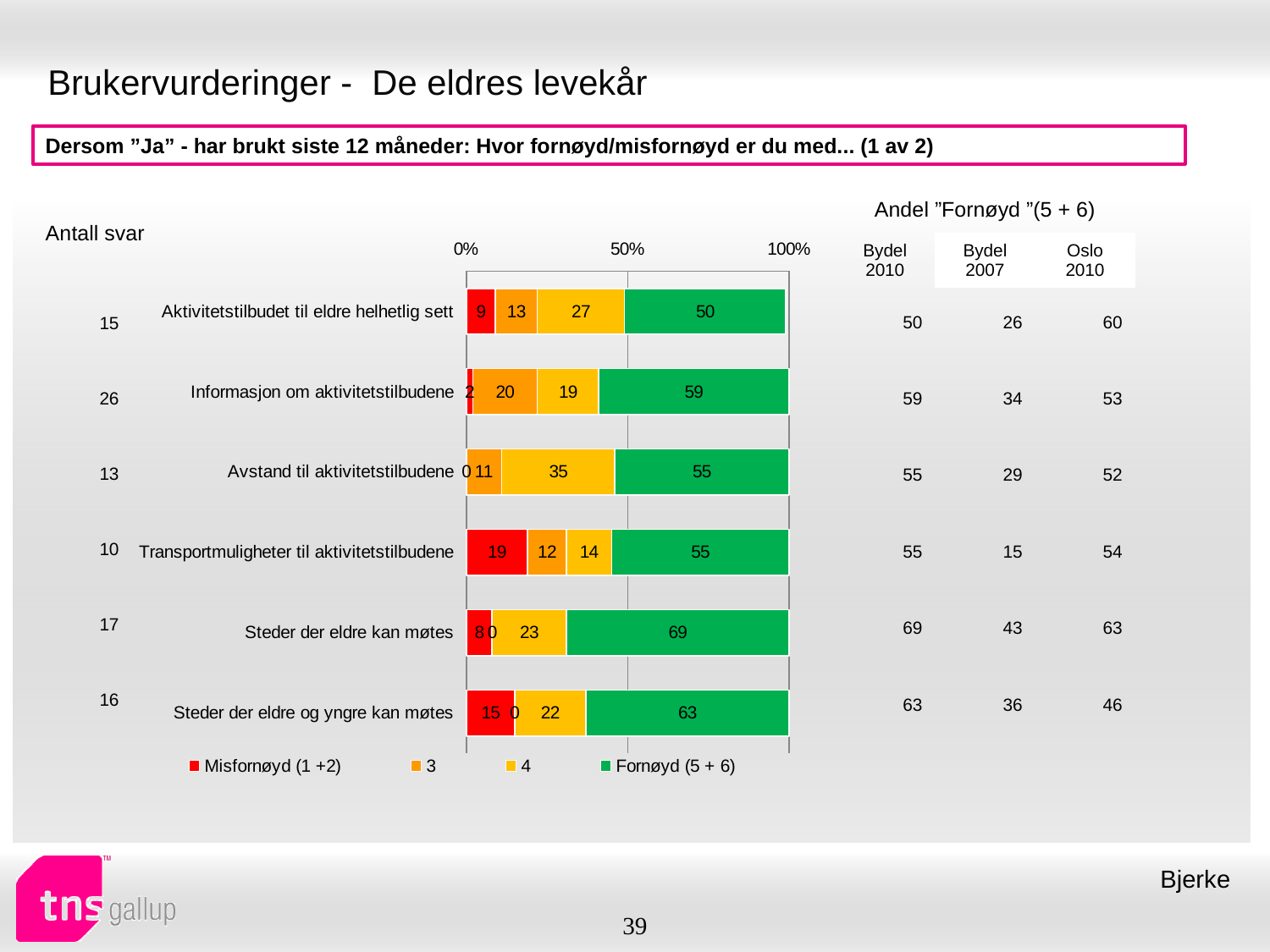
Which category has the lowest value for the Fornøyd (5 + 6) series? Aktivitetstilbudet til eldre helhetlig sett Which colour represents the Fornøyd (5 + 6) series in the chart? Green How many series does the chart legend list? 4 How many categories are shown in the chart? 6 Which category has the highest value for the Fornøyd (5 + 6) series? Steder der eldre kan møtes What is the value of the Fornøyd (5 + 6) series for "Aktivitetstilbudet til eldre helhetlig sett"? 50 What is the total of the stacked bar for "Informasjon om aktivitetstilbudene"? 100 What is the difference between the Fornøyd (5 + 6) values for "Steder der eldre kan møtes" and "Steder der eldre og yngre kan møtes"? 6 What is the value of the Misfornøyd (1 +2) series for "Transportmuligheter til aktivitetstilbudene"? 19 What kind of chart is shown on the slide? Stacked bar chart What is the value of the "4" series for "Avstand til aktivitetstilbudene"? 35 Which is larger: the "3" series value for "Informasjon om aktivitetstilbudene" or for "Transportmuligheter til aktivitetstilbudene"? Informasjon om aktivitetstilbudene